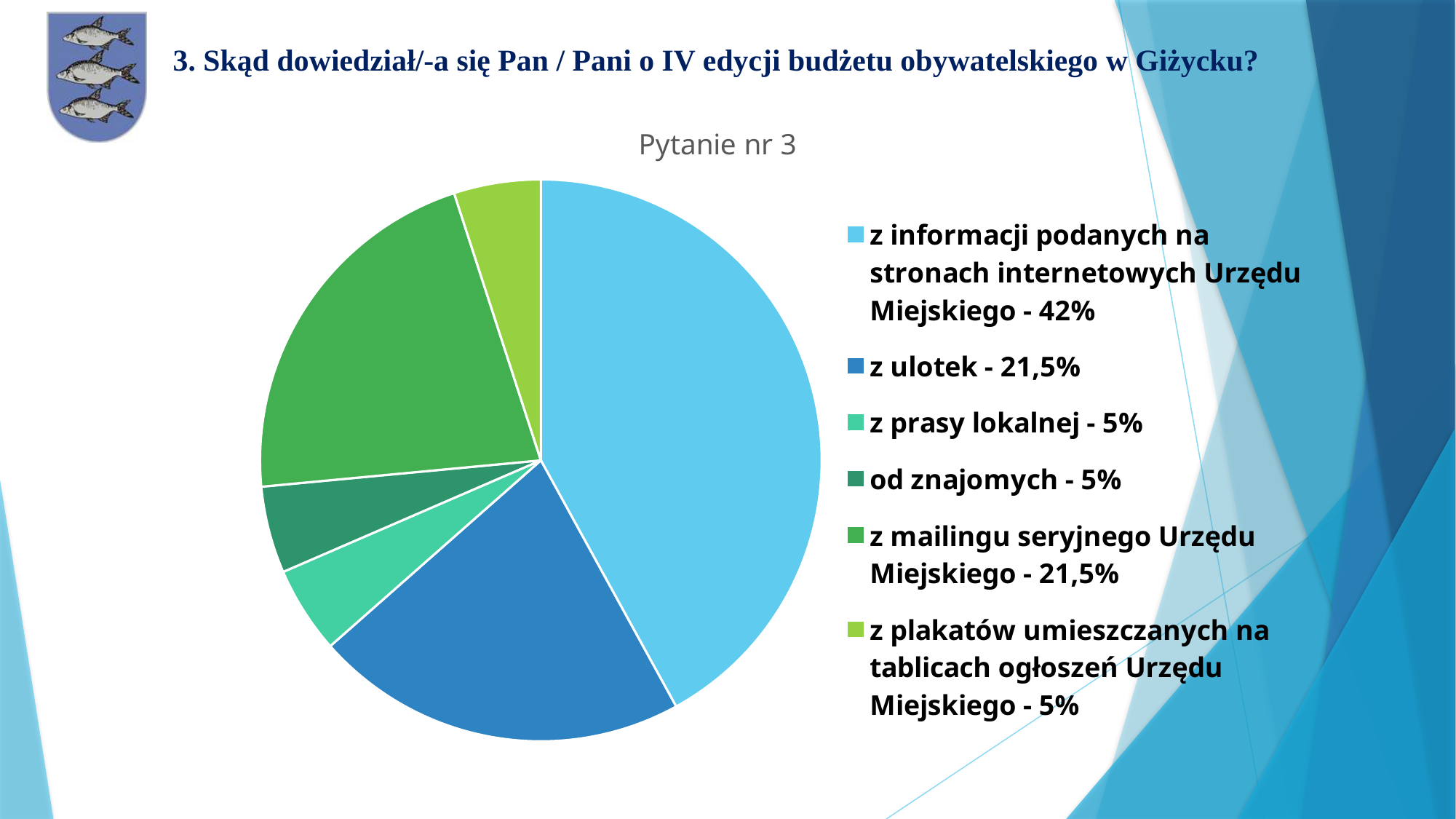
What is the title of the chart? Pytanie nr 3 Which is larger: the share for 'z ulotek' or the share for 'od znajomych'? z ulotek How many slices does the pie chart have? 6 What is the value for 'z plakatów umieszczanych na tablicach ogłoszeń Urzędu Miejskiego'? 5% What is the value for 'z prasy lokalnej'? 5% What is the value for 'z mailingu seryjnego Urzędu Miejskiego'? 21,5% What kind of chart is shown on the slide? pie chart What is the difference between the share for 'z informacji podanych na stronach internetowych Urzędu Miejskiego' and the share for 'z ulotek'? 20,5% What share of respondents learned about the budget from 'z informacji podanych na stronach internetowych Urzędu Miejskiego'? 42% Which category has the largest share of the pie? z informacji podanych na stronach internetowych Urzędu Miejskiego What colour is the slice for 'z ulotek'? blue What is the value for 'z ulotek'? 21,5%